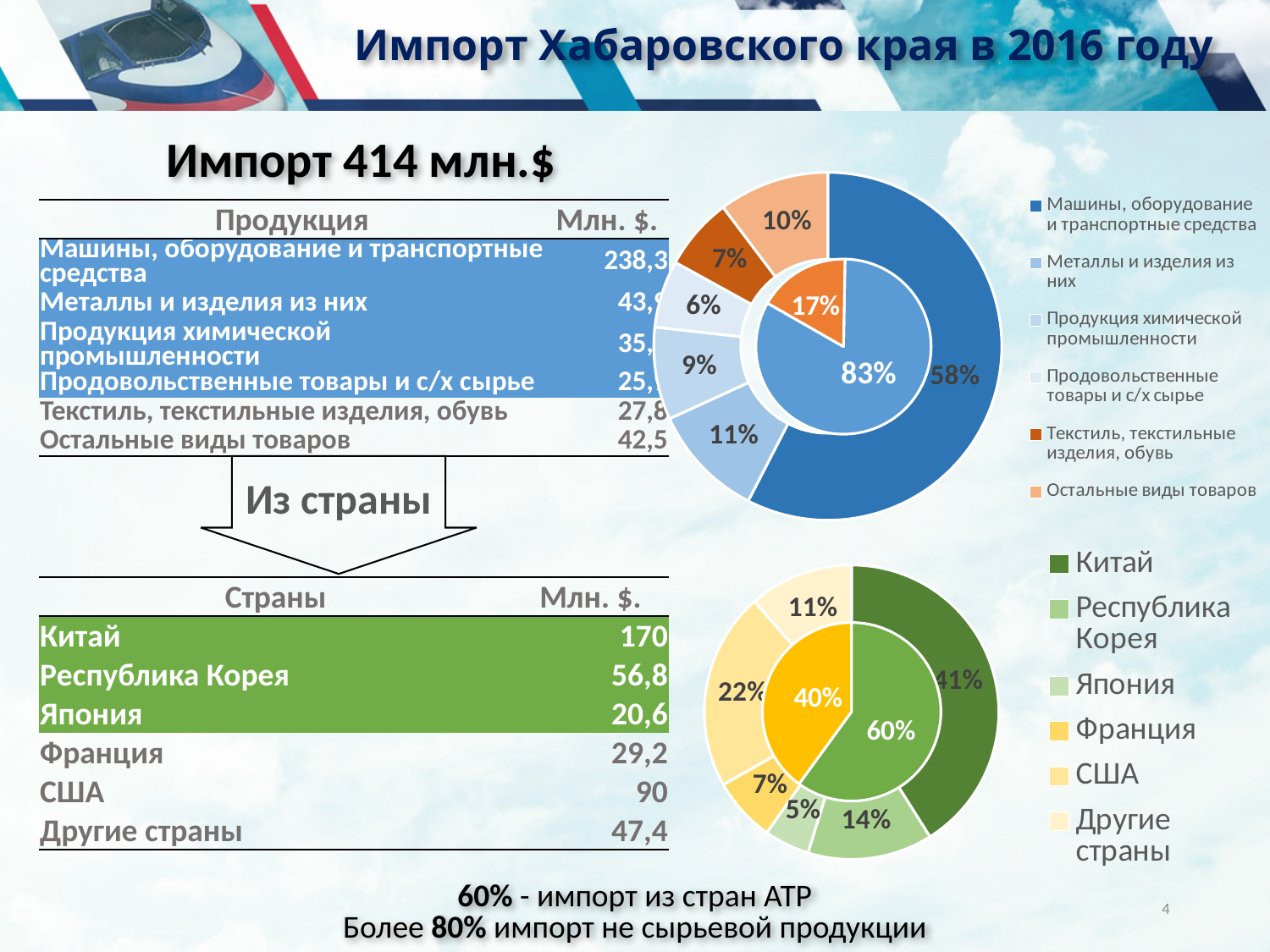
In the bottom chart (countries), what is the difference in percentage points between the shares of 'Китай' and 'Республика Корея'? 27 In the top chart (products), what percentage share is shown for 'Машины, оборудование и транспортные средства'? 58% What kind of chart is the bottom chart (countries)? Doughnut chart In the bottom chart (countries), which has the larger share, 'Франция' or 'США'? США How many entries does the legend of the top chart (products) list? 6 In the bottom chart (countries), which country has the smallest share? Япония In the top chart (products), which category has the smallest share? Продовольственные товары и с/х сырье In the top chart (products), which category has the largest share? Машины, оборудование и транспортные средства In the top chart (products), what percentage share is shown for 'Остальные виды товаров'? 10% In the bottom chart (countries), what percentage share is shown for 'Китай'? 41% In the top chart (products), what percentage share is shown for 'Металлы и изделия из них'? 11% In the bottom chart (countries), what percentage share is shown for 'США'? 22%